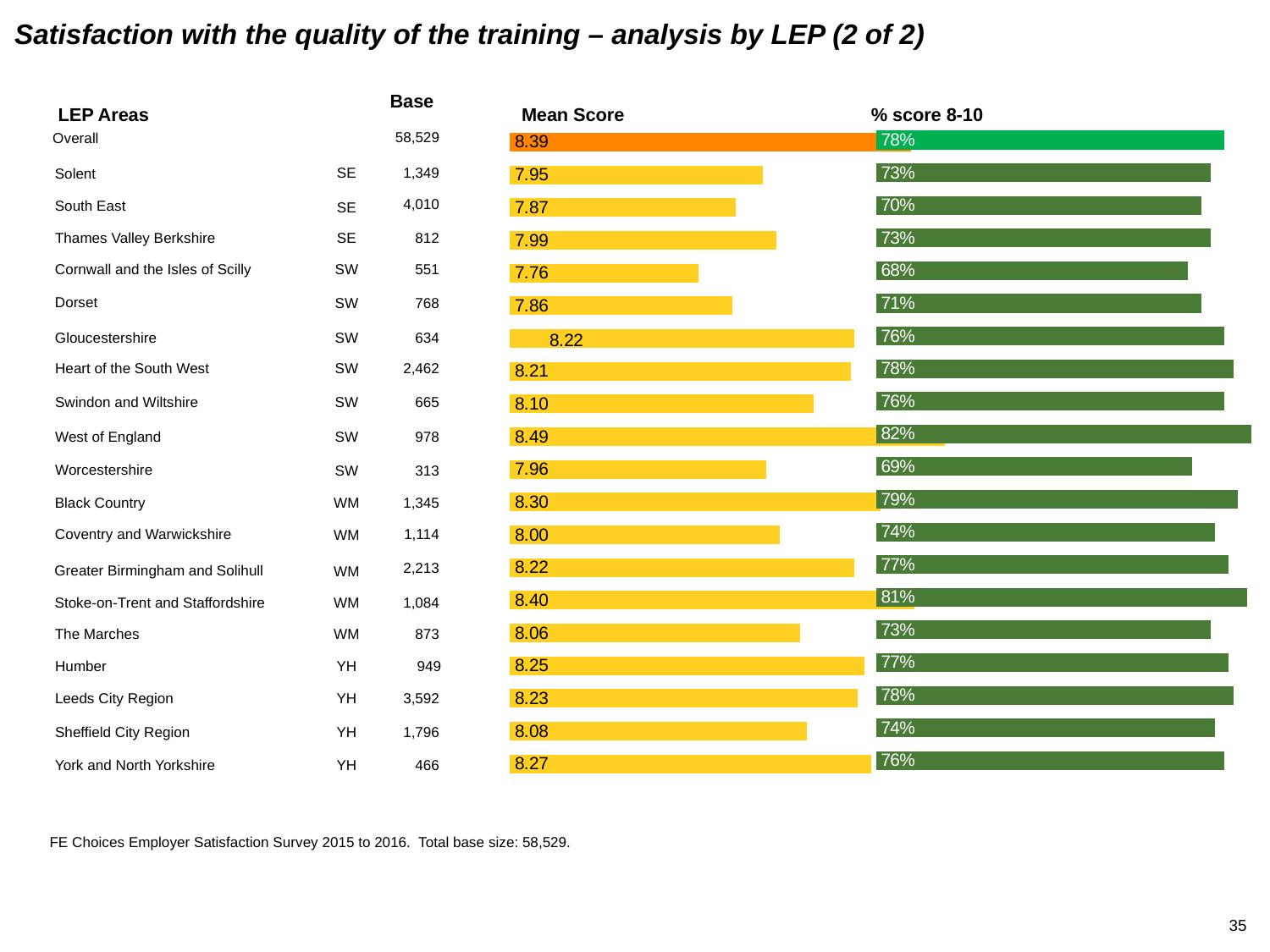
In the % score 8-10 chart, what is the value for Stoke-on-Trent and Staffordshire? 81% In the Mean Score chart, which is larger: the mean score for Black Country or for Coventry and Warwickshire? Black Country In the Mean Score chart, what is the mean score for West of England? 8.49 In the Mean Score chart, which LEP area has the highest mean score? West of England In the % score 8-10 chart, what is the value for Overall? 78% How many bars are plotted in the Mean Score chart, including Overall? 20 In the % score 8-10 chart, what is the difference between the values for West of England and Worcestershire? 13% In the % score 8-10 chart, which is larger: the value for Dorset or for Gloucestershire? Gloucestershire In the Mean Score chart, what is the mean score for Cornwall and the Isles of Scilly? 7.76 In the % score 8-10 chart, which LEP area has the lowest value? Cornwall and the Isles of Scilly What type of chart is used to show the % score 8-10 values? Bar chart In the Mean Score chart, what is the difference between the mean scores for West of England and Cornwall and the Isles of Scilly? 0.73